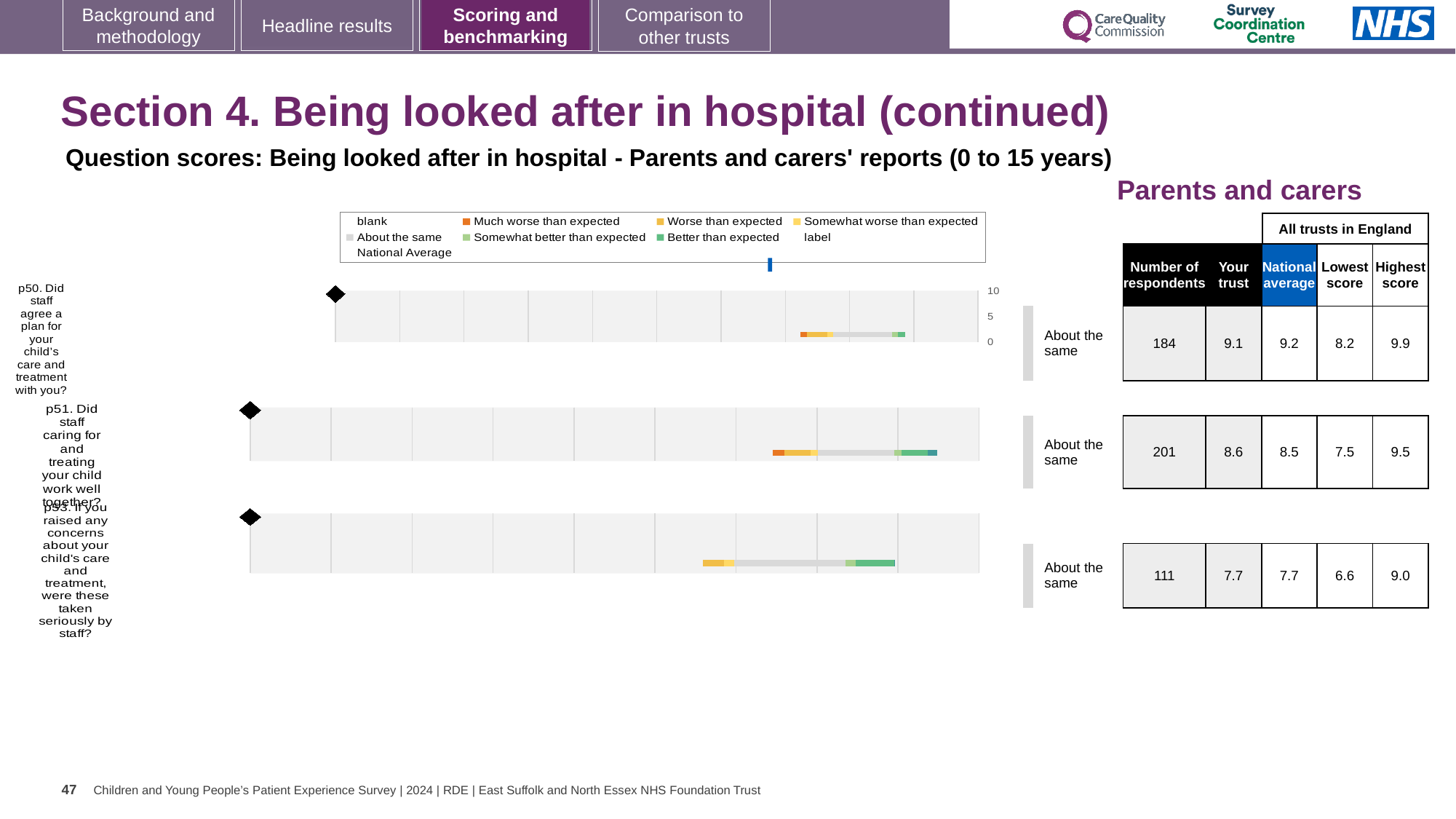
How many questions are plotted on this slide? 3 What is the 'Your trust' score for question p51 (Did staff caring for and treating your child work well together?)? 8.6 What is the lowest score among all trusts in England for question p51? 7.5 For question p53, what is the difference between the highest score and the lowest score among all trusts in England? 2.4 How many respondents are shown for question p50 (Did staff agree a plan for your child's care and treatment with you?)? 184 For question p51, which is larger: the 'Your trust' score or the national average? Your trust What is the national average score for question p53 (If you raised any concerns about your child's care and treatment, were these taken seriously by staff?)? 7.7 What is the highest score among all trusts in England for question p50? 9.9 What benchmark category is shown for question p50? About the same What kind of chart is used to show each question's score? Bar chart Which of the three questions shown has the highest 'Your trust' score? p50 Which of the three questions shown has the lowest number of respondents? p53